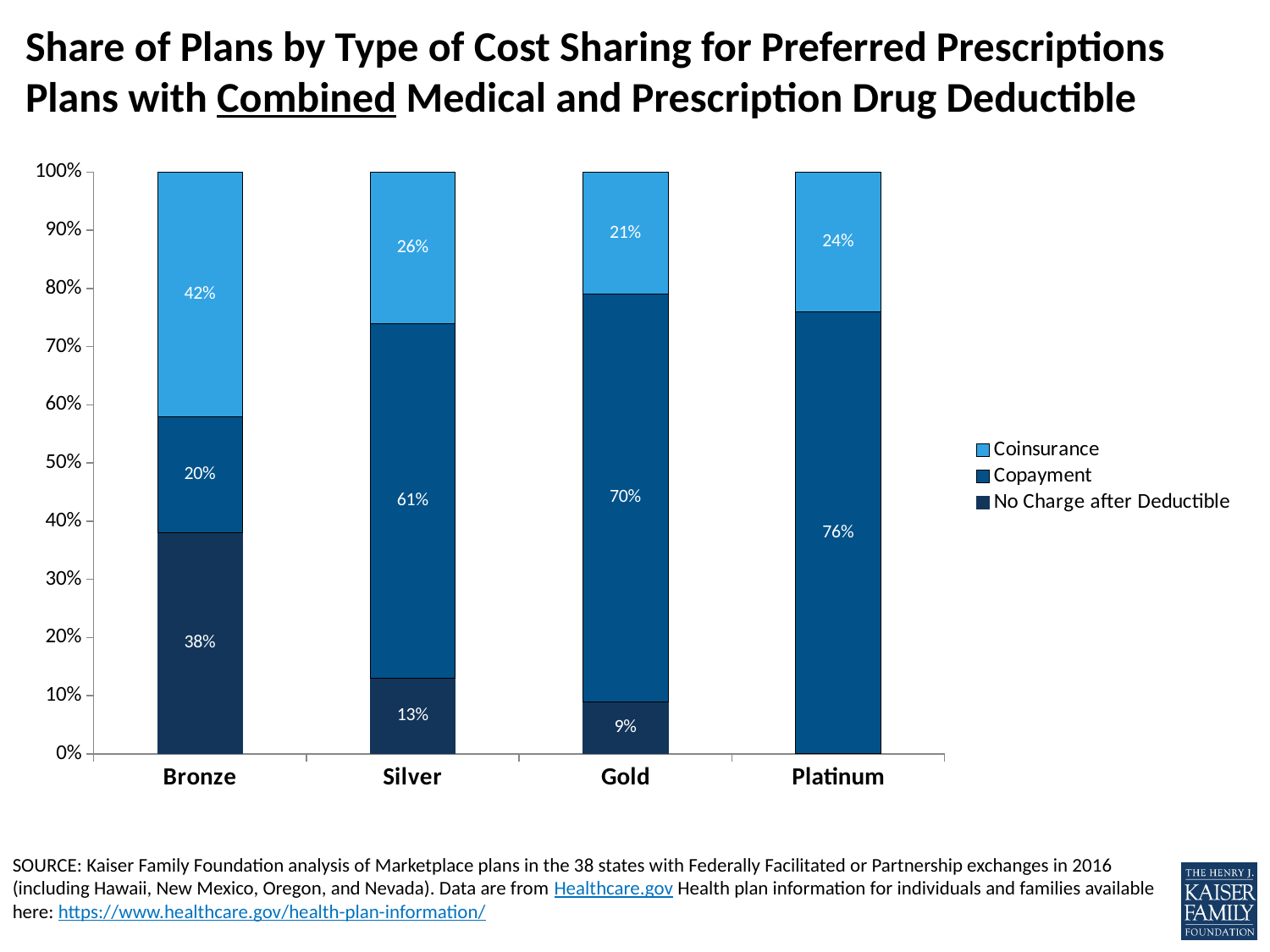
What is the Coinsurance share for Bronze plans? 42% How many series does the legend list? 3 Does the Copayment share rise or fall from Bronze to Platinum? Rise Which word in the chart title is underlined? Combined Which metal level has the highest Copayment share? Platinum Which metal level has the lowest Coinsurance share? Gold What is the Copayment share for Gold plans? 70% What is the No Charge after Deductible share for Silver plans? 13% What is the difference between the Copayment share for Silver and the Copayment share for Bronze? 41 percentage points Which is larger: the No Charge after Deductible share for Bronze or for Gold? Bronze What kind of chart is shown on the slide? Stacked bar chart How many metal levels are shown on the x axis? 4